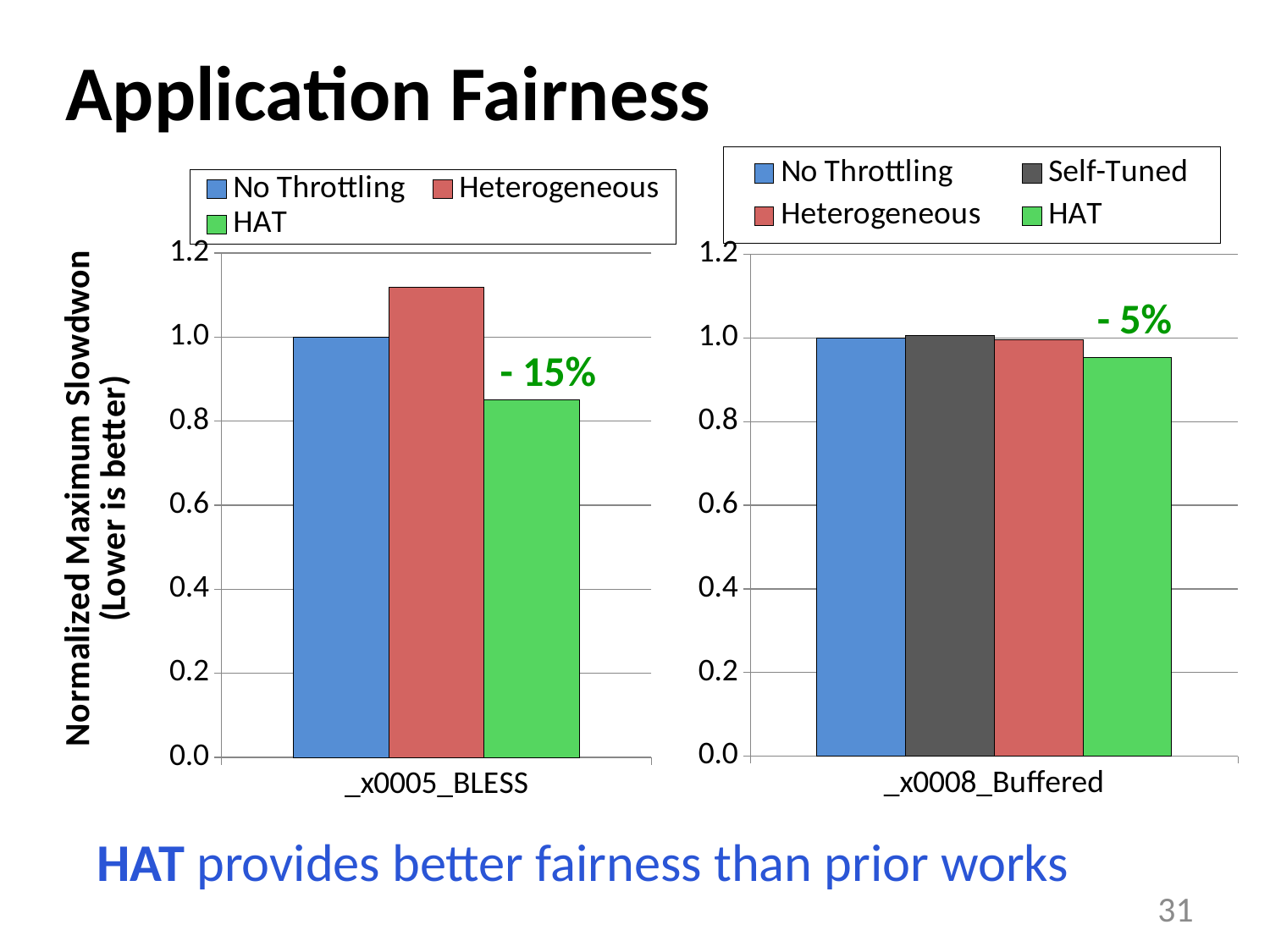
What percentage reduction is annotated above the HAT bar in the left chart (_x0005_BLESS)? - 15% In the right chart (_x0008_Buffered), which series has the lowest value? HAT In the left chart (_x0005_BLESS), which is larger, Heterogeneous or HAT? Heterogeneous In the left chart (_x0005_BLESS), is the value for Heterogeneous greater or less than 1.0? greater In the left chart (_x0005_BLESS), how many series does the legend list? 3 In the right chart (_x0008_Buffered), how many series does the legend list? 4 In the right chart (_x0008_Buffered), what is the value for No Throttling? 1.0 In the left chart (_x0005_BLESS), what is the value for No Throttling? 1.0 What kind of chart is the left chart (_x0005_BLESS)? bar chart In the right chart (_x0008_Buffered), is the value for HAT greater or less than 1.0? less In the left chart (_x0005_BLESS), which series has the lowest value? HAT In the left chart (_x0005_BLESS), which series has the highest value? Heterogeneous